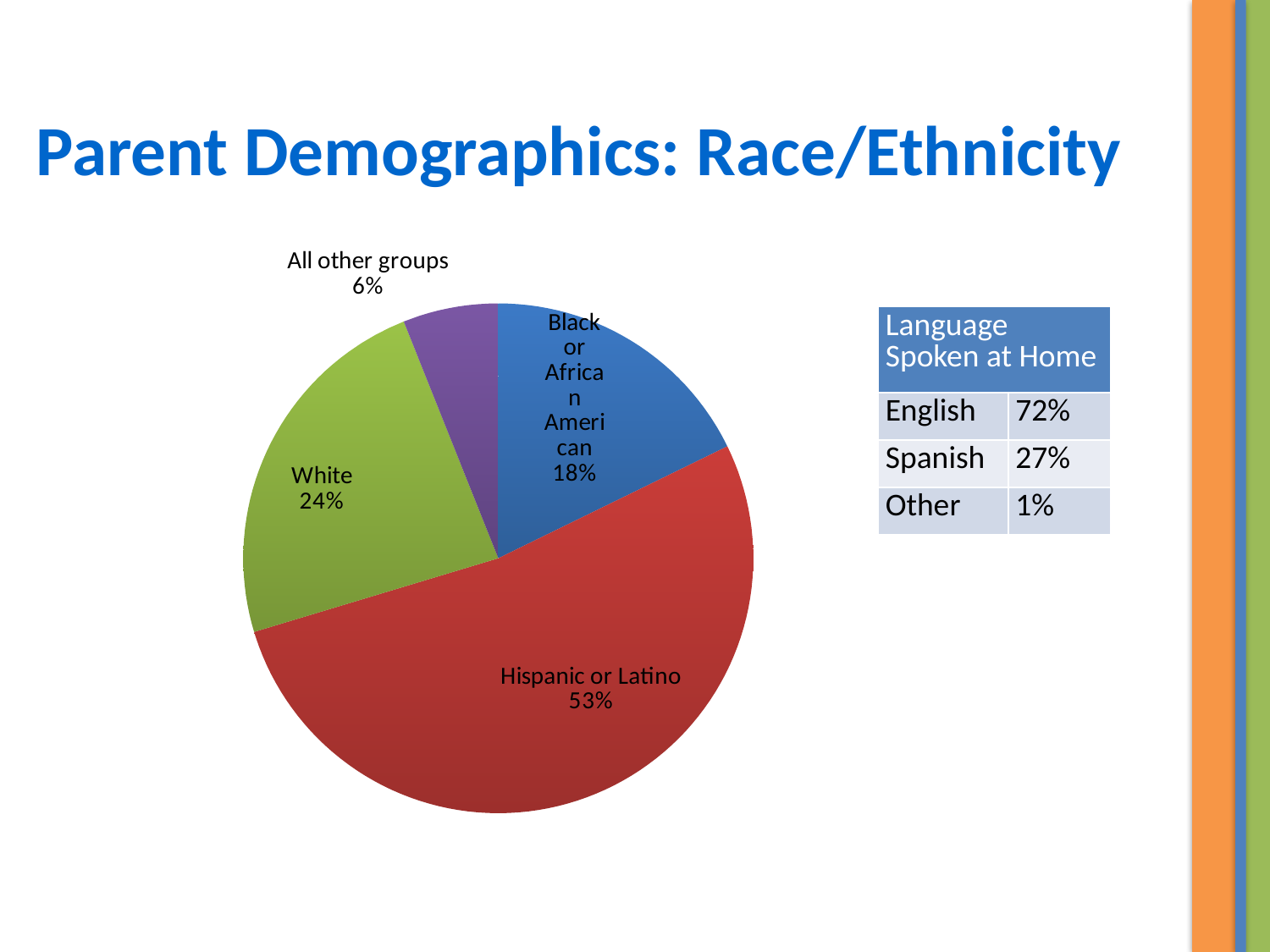
What percentage is shown for White? 24% Which group has the smallest slice of the pie? All other groups What share of the pie is Hispanic or Latino? 53% What is the difference in percentage points between Hispanic or Latino and White? 29 What colour is the Hispanic or Latino slice? red What percentage is shown for Black or African American? 18% What percentage is shown for All other groups? 6% What is the difference in percentage points between White and Black or African American? 6 What kind of chart is shown on the slide? pie chart Which group has the largest slice of the pie? Hispanic or Latino How many slices does the pie chart have? 4 Which is larger, the White slice or the Black or African American slice? White